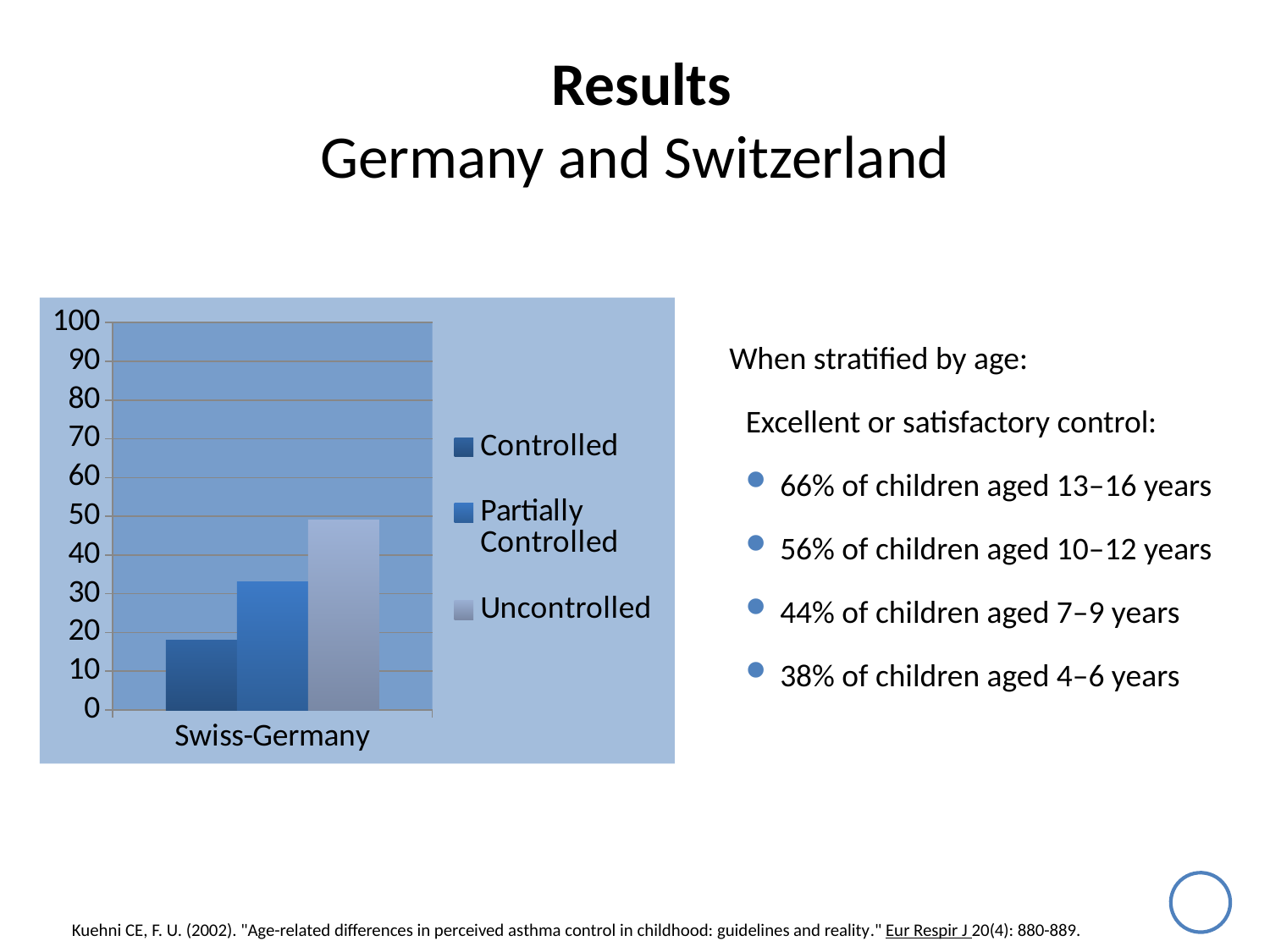
Which series has the highest bar for Swiss-Germany? Uncontrolled What kind of chart is shown on the slide? bar chart How many categories are shown on the x axis of the chart? 1 What is the category label shown on the x axis of the chart? Swiss-Germany Which series has the lowest bar for Swiss-Germany? Controlled Is the bar for Partially Controlled larger or smaller than the bar for Controlled? larger Is the value for Uncontrolled greater or less than 40? greater Is the bar for Uncontrolled larger or smaller than the bar for Partially Controlled? larger How many series does the chart legend list? 3 What is the highest value shown on the chart's vertical axis? 100